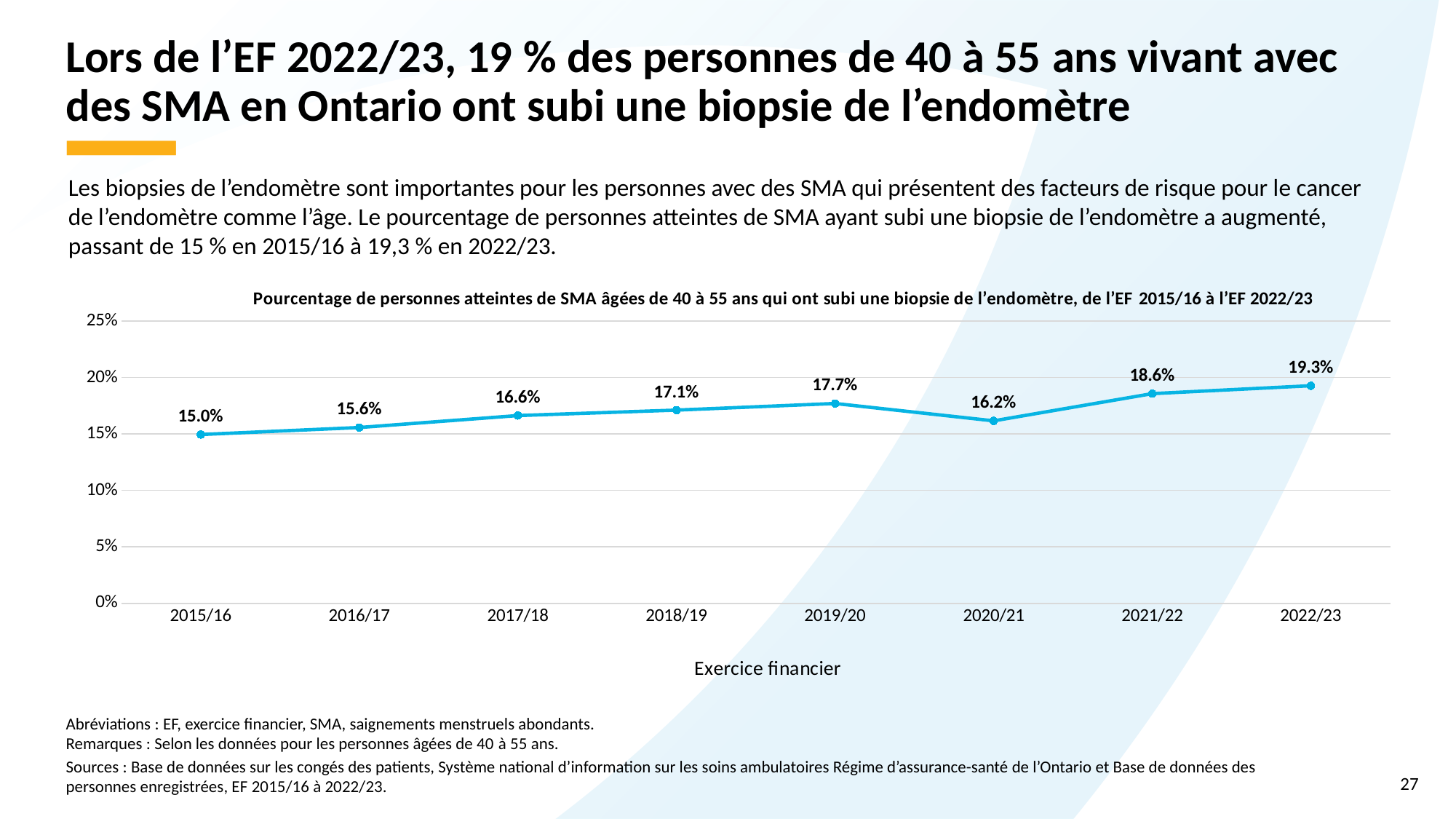
What is the value shown for 2020/21? 16.2% Is the value for 2021/22 greater or less than 15%? greater What is the difference between the values for 2022/23 and 2015/16? 4.3 percentage points Which is larger, the value for 2019/20 or the value for 2020/21? 2019/20 What is the label of the x axis? Exercice financier What is the difference between the values for 2019/20 and 2020/21? 1.5 percentage points How many fiscal years are plotted on the chart? 8 What is the value shown for 2022/23? 19.3% What percentage of people with SMA aged 40 to 55 had an endometrial biopsy in 2015/16? 15.0% Which fiscal year has the highest percentage? 2022/23 Which fiscal year has the lowest percentage? 2015/16 What kind of chart is shown on the slide? Line chart